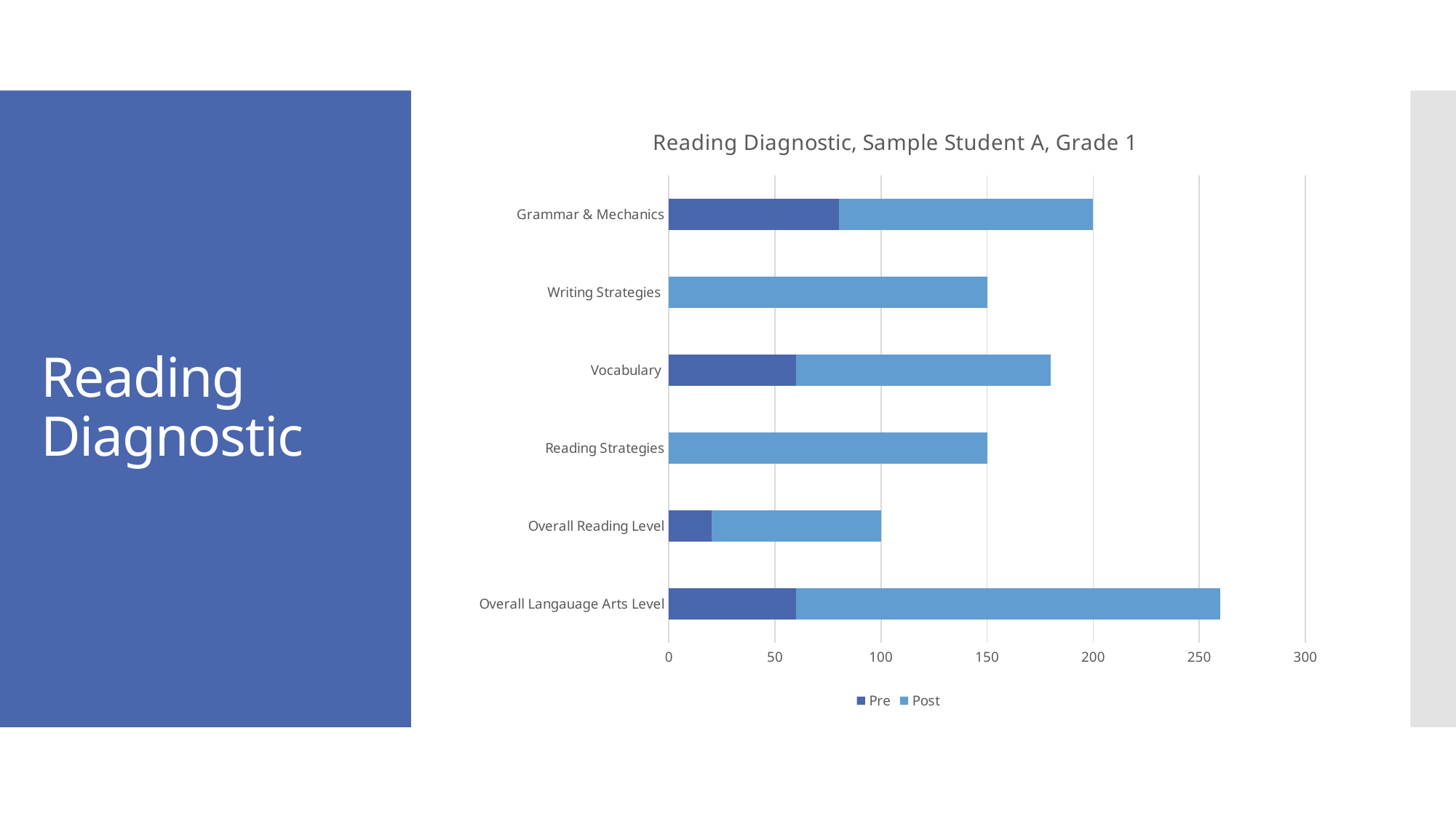
What kind of chart is shown on the slide? Bar chart What is the total length of the stacked bar for Grammar & Mechanics? 200 What is the total length of the stacked bar for Overall Reading Level? 100 Is the total value for Vocabulary greater or less than 200? less Which category has the shortest total bar? Overall Reading Level How many series does the legend list? 2 How many categories are plotted on the chart? 6 What is the total length of the stacked bar for Writing Strategies? 150 Which category has the longest total bar? Overall Langauage Arts Level Is the total value for Overall Langauage Arts Level greater or less than 250? greater What is the title of the chart? Reading Diagnostic, Sample Student A, Grade 1 Which has the larger total bar, Grammar & Mechanics or Vocabulary? Grammar & Mechanics